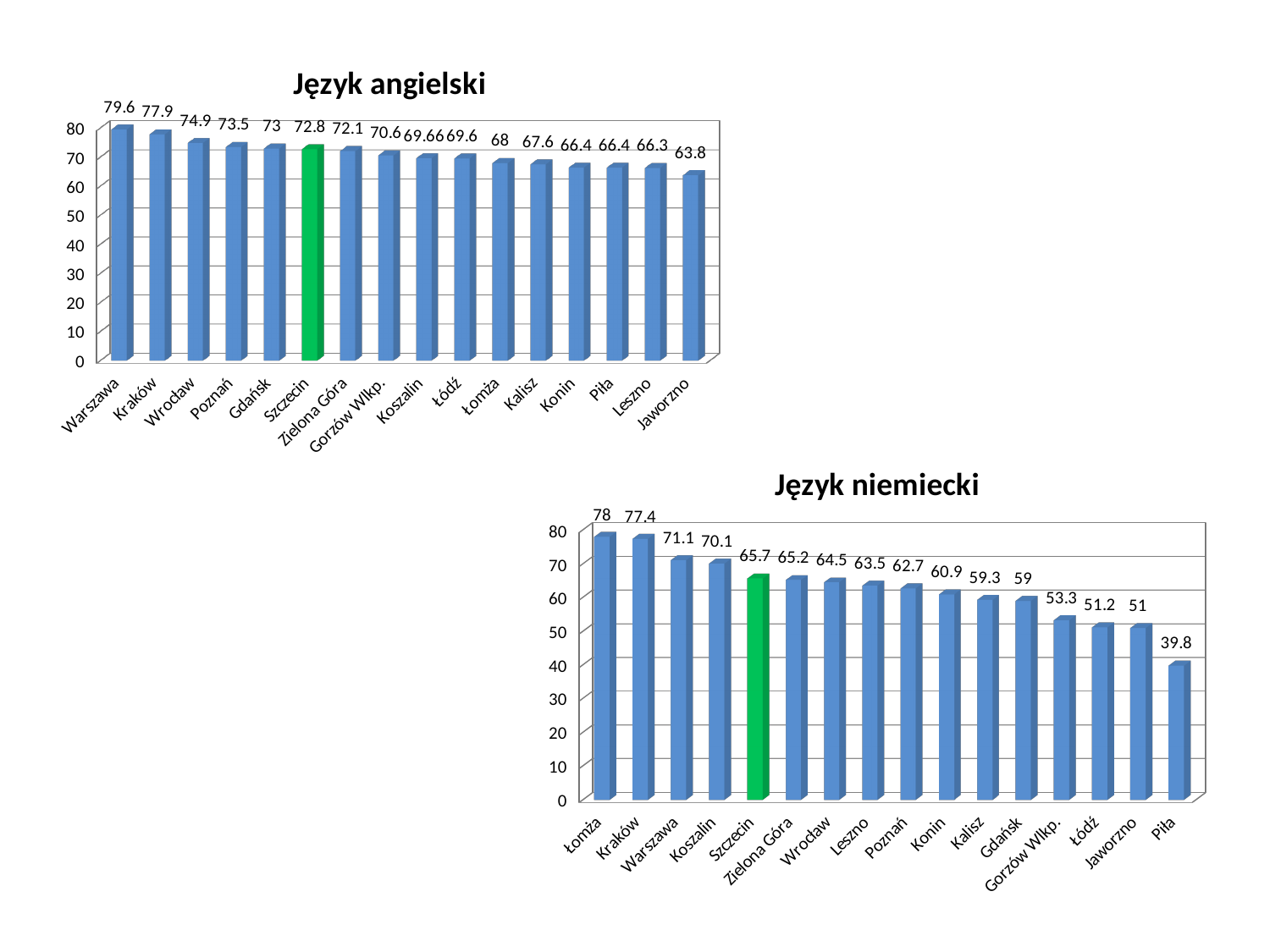
In the 'Język niemiecki' chart, what is the difference between the values for Łomża and Kraków? 0.6 In the 'Język niemiecki' chart, which city has the lowest value? Piła In the 'Język angielski' chart, which city has the highest value? Warszawa In the 'Język angielski' chart, what is the difference between the values for Warszawa and Jaworzno? 15.8 How many cities are shown in the 'Język angielski' chart? 16 In the 'Język niemiecki' chart, which is larger, the value for Koszalin or the value for Szczecin? Koszalin What type of chart is the 'Język niemiecki' chart? Bar chart In the 'Język angielski' chart, which city has the lowest value? Jaworzno In the 'Język angielski' chart, which bar is coloured green? Szczecin In the 'Język angielski' chart, what is the value for Szczecin? 72.8 In the 'Język niemiecki' chart, what is the value for Piła? 39.8 In the 'Język niemiecki' chart, which city has the highest value? Łomża